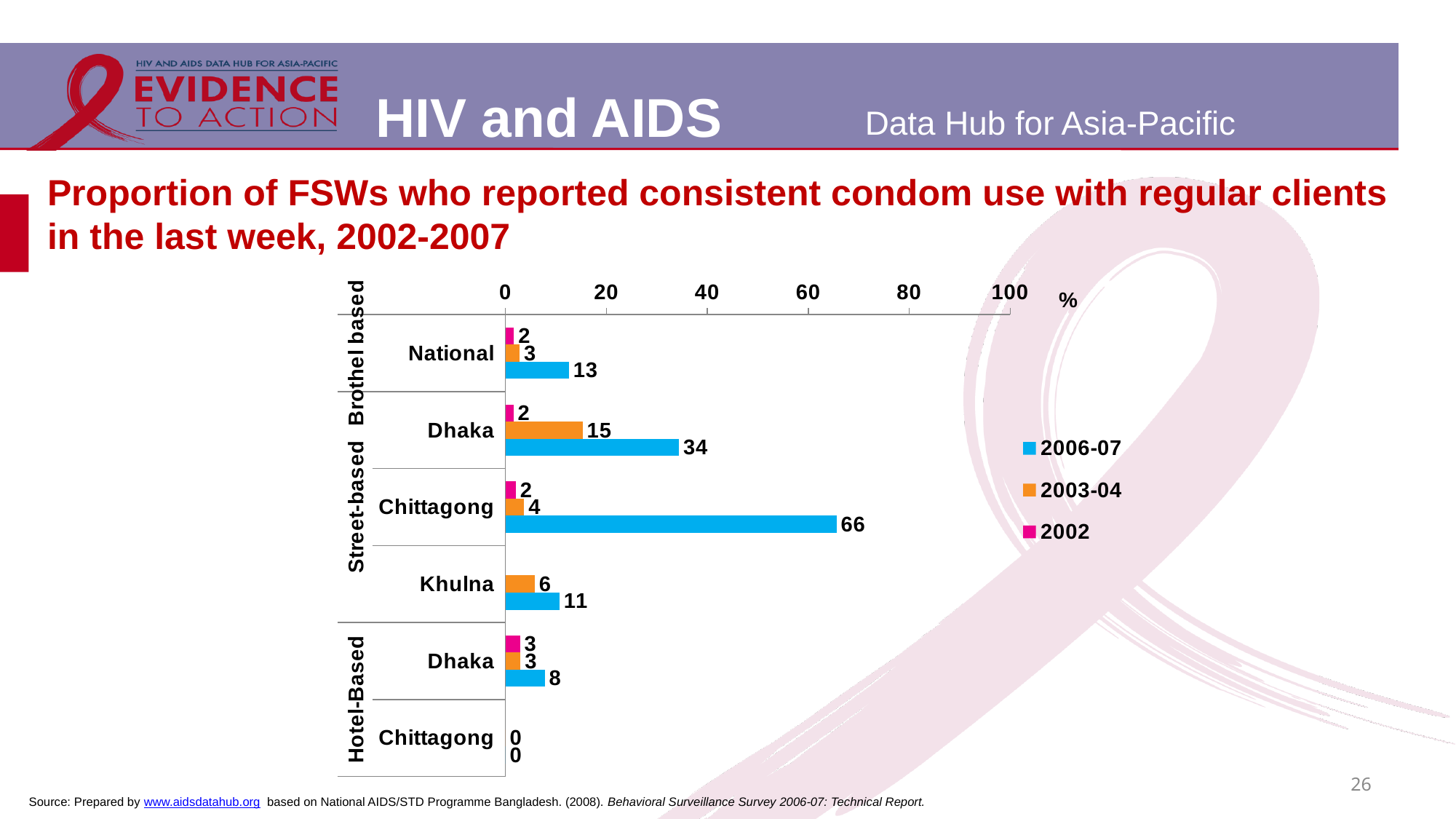
Is the 2006-07 value for street-based Chittagong greater or less than 60? greater How many series does the legend list? 3 What is the 2003-04 value for Khulna? 6 What is the 2006-07 value for hotel-based FSWs in Dhaka? 8 Which colour represents the 2002 series in the legend? pink Which is larger: the 2006-07 value for Khulna or the 2006-07 value for National? National What is the 2006-07 value for National (brothel based)? 13 What is the difference between the 2006-07 and 2003-04 values for street-based FSWs in Dhaka? 19 What is the 2003-04 value for street-based FSWs in Dhaka? 15 What is the 2006-07 value for street-based FSWs in Chittagong? 66 Which category has the highest 2006-07 value? Chittagong (street-based) What type of chart is shown on the slide? bar chart